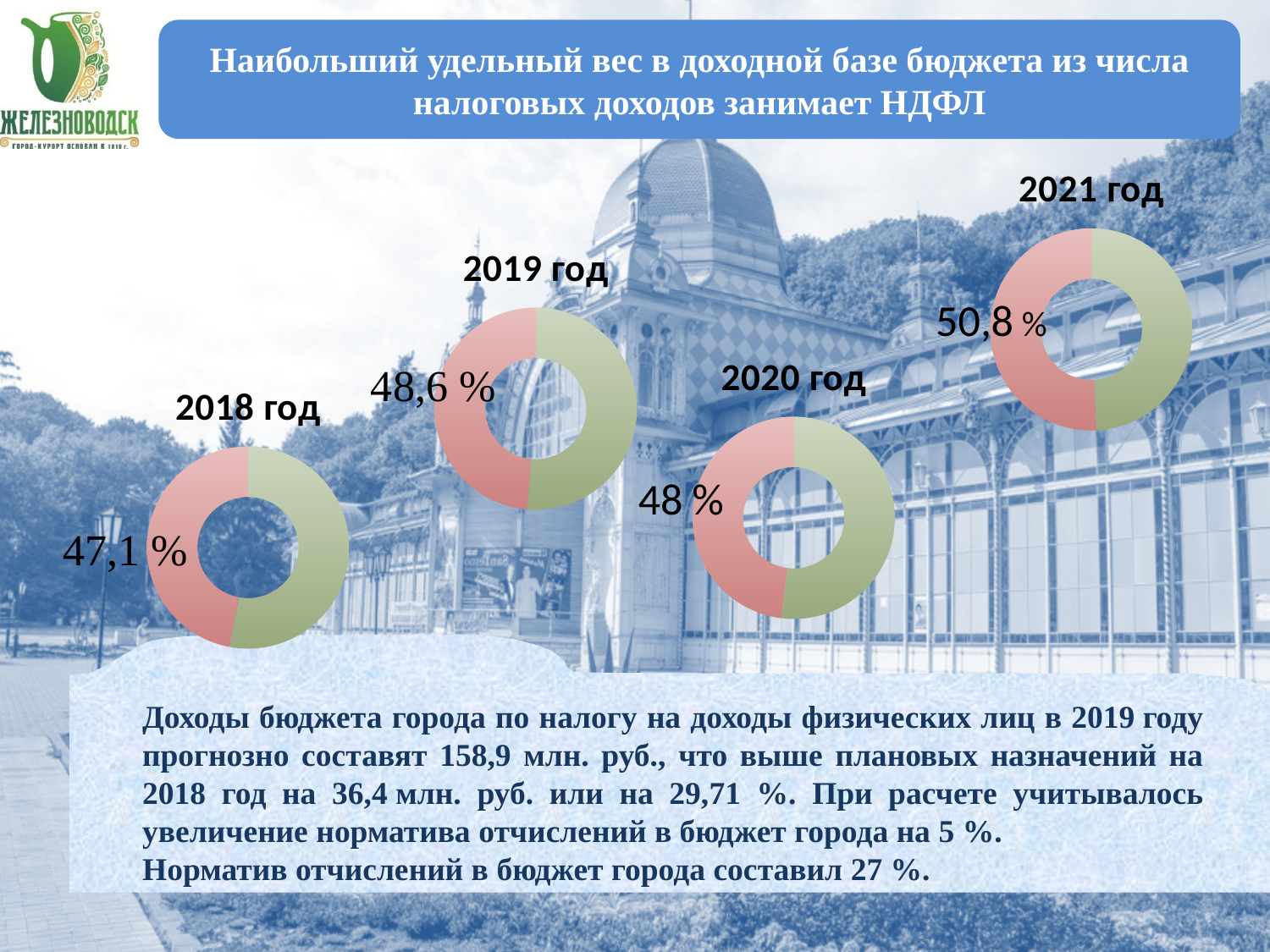
Which is larger, the share shown for 2019 год or for 2020 год? 2019 год What kind of chart is used to show the share for each year? Doughnut chart What share is shown on the doughnut chart for 2021 год? 50,8 % What share is shown on the doughnut chart for 2018 год? 47,1 % Which year's doughnut chart shows the highest share? 2021 год How many slices does each doughnut chart have? 2 What share is shown on the doughnut chart for 2020 год? 48 % Which year's doughnut chart shows the lowest share? 2018 год What share is shown on the doughnut chart for 2019 год? 48,6 % Does the share rise or fall from 2018 год to 2019 год? Rise How many doughnut charts are on the slide? 4 By how many percentage points does the share for 2021 год exceed the share for 2018 год? 3,7